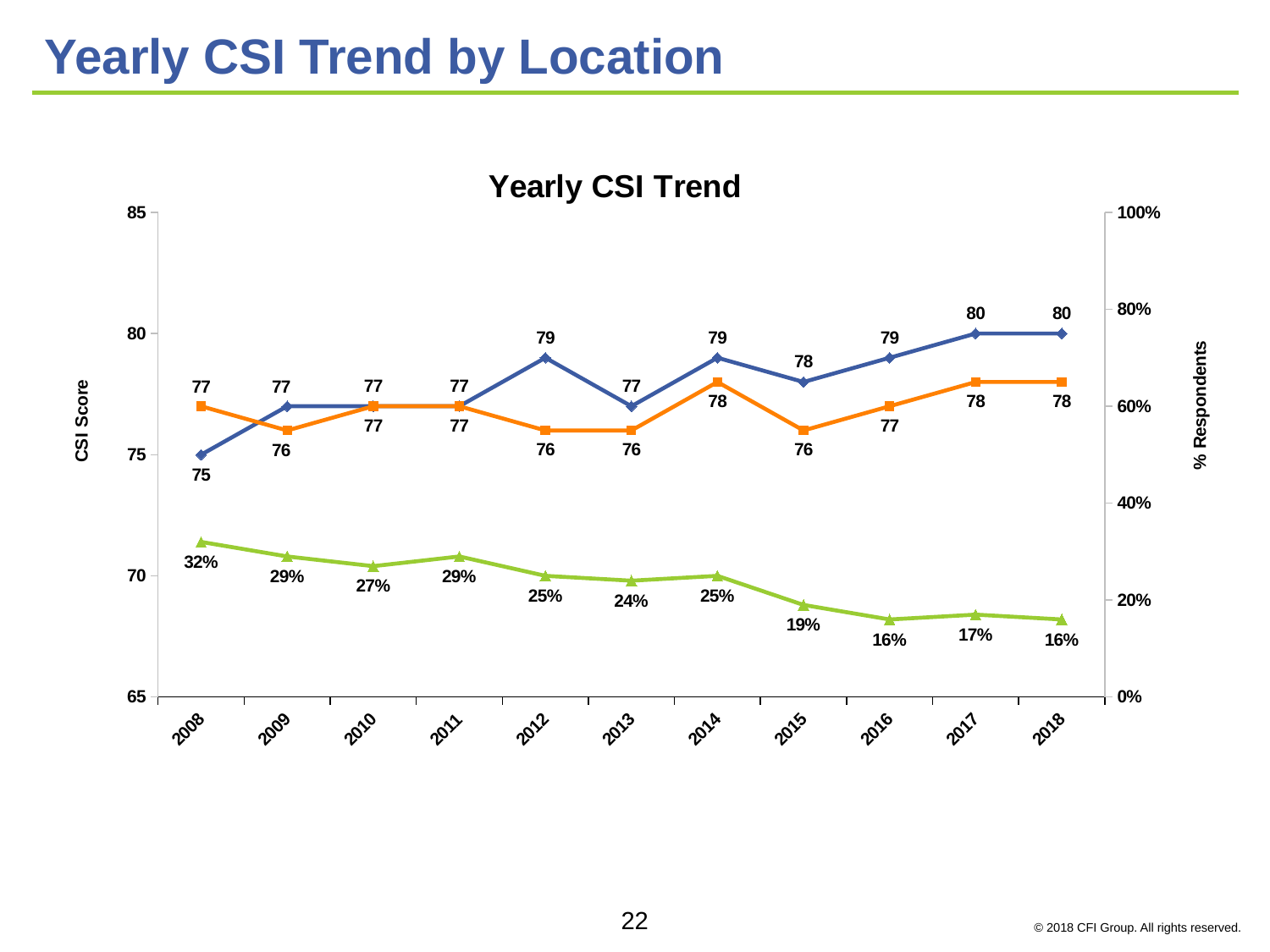
What is the title of the chart? Yearly CSI Trend What is the value of the orange line in 2014? 78 In 2012, which line has the higher value, the blue line or the orange line? Blue line In which year does the green line reach its highest value? 2008 Does the green line generally rise or fall from 2008 to 2018? Fall What percentage does the green line show for 2015? 19% What type of chart is shown on the slide? Line chart In which year does the blue line have its lowest value? 2008 What is the value of the blue line in 2008? 75 What is the difference between the blue line's value in 2018 and its value in 2008? 5 What is the label of the right-hand vertical axis? % Respondents How many years are plotted along the x axis of the Yearly CSI Trend chart? 11